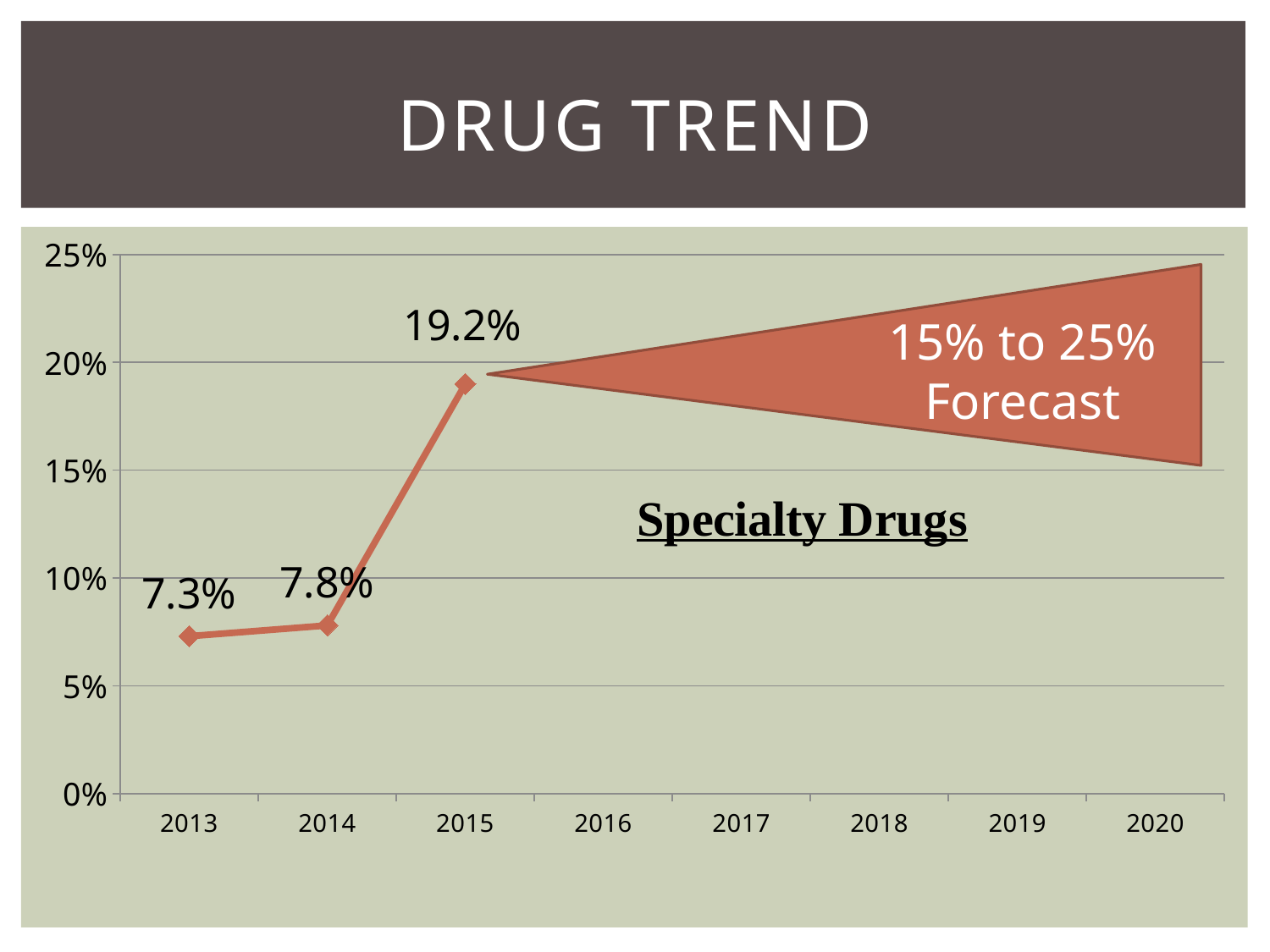
What is the value for 2013? 7.3% What is the difference between the 2015 value and the 2014 value? 11.4% How many data points are plotted on the line? 3 What is the value for 2015? 19.2% Which is larger, the value for 2015 or the value for 2013? 2015 Do the plotted values rise or fall from 2013 to 2015? rise What kind of chart is shown on the slide? line chart Which year has the lowest plotted value? 2013 Which year has the highest plotted value? 2015 What is the difference between the 2014 value and the 2013 value? 0.5% What is the value for 2014? 7.8% Is the value for 2015 greater or less than 15%? greater